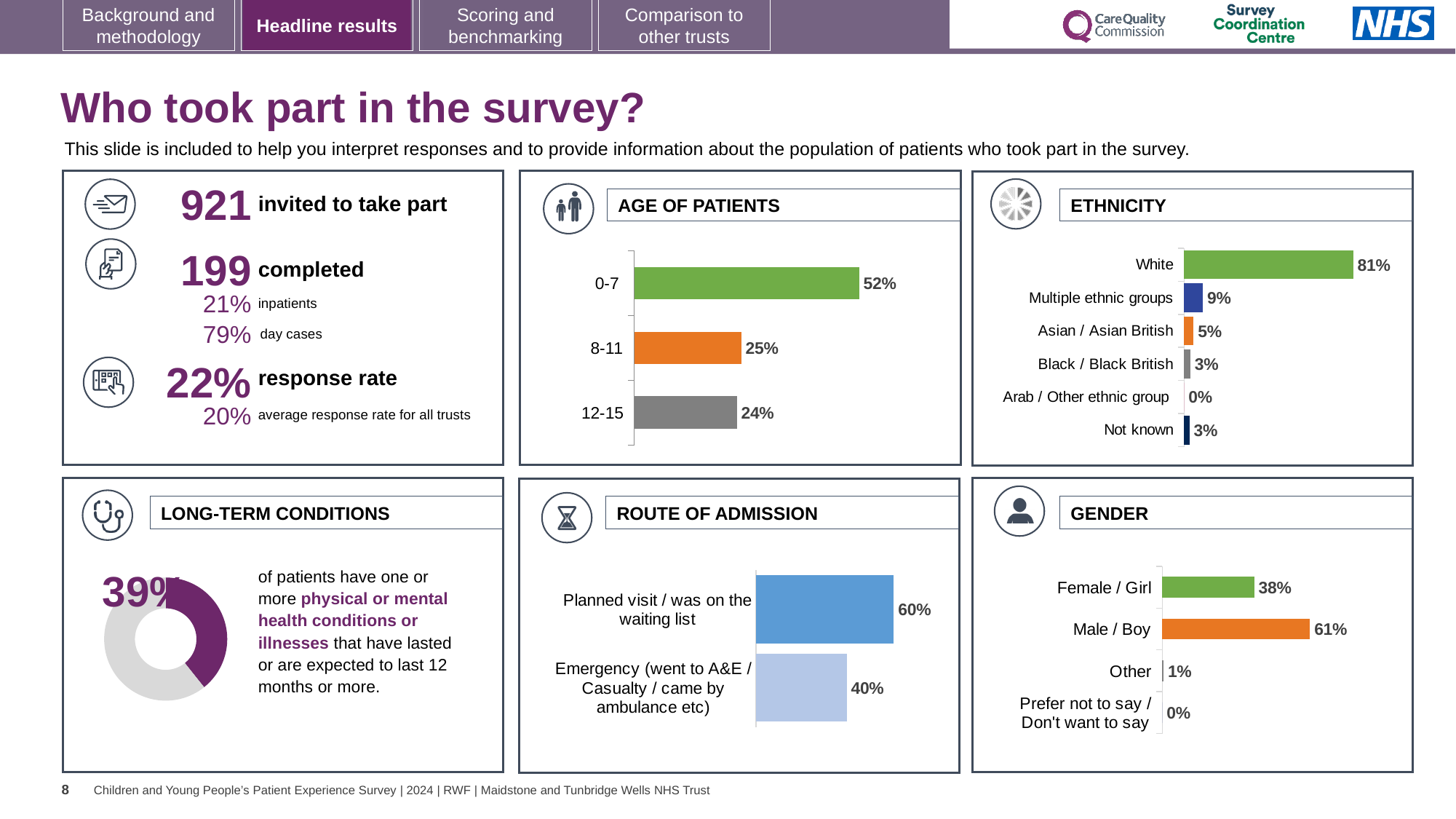
In the AGE OF PATIENTS chart, what percentage of patients are aged 0-7? 52% In the GENDER chart, what percentage of patients are Male / Boy? 61% In the GENDER chart, what is the difference between the Male / Boy and Female / Girl percentages? 23% In the ETHNICITY chart, what is the difference between the percentages for Multiple ethnic groups and Asian / Asian British? 4% In the ROUTE OF ADMISSION chart, which route has the larger percentage: Planned visit / was on the waiting list or Emergency? Planned visit / was on the waiting list In the ETHNICITY chart, how many ethnicity categories are listed? 6 In the ETHNICITY chart, what percentage of patients are White? 81% In the AGE OF PATIENTS chart, which age group has the lowest percentage? 12-15 In the ROUTE OF ADMISSION chart, what percentage of patients had a planned visit / were on the waiting list? 60% In the AGE OF PATIENTS chart, how many age groups are shown? 3 What kind of chart is used in the LONG-TERM CONDITIONS panel? Pie chart (donut) In the LONG-TERM CONDITIONS chart, what share of patients have one or more long-term conditions? 39%